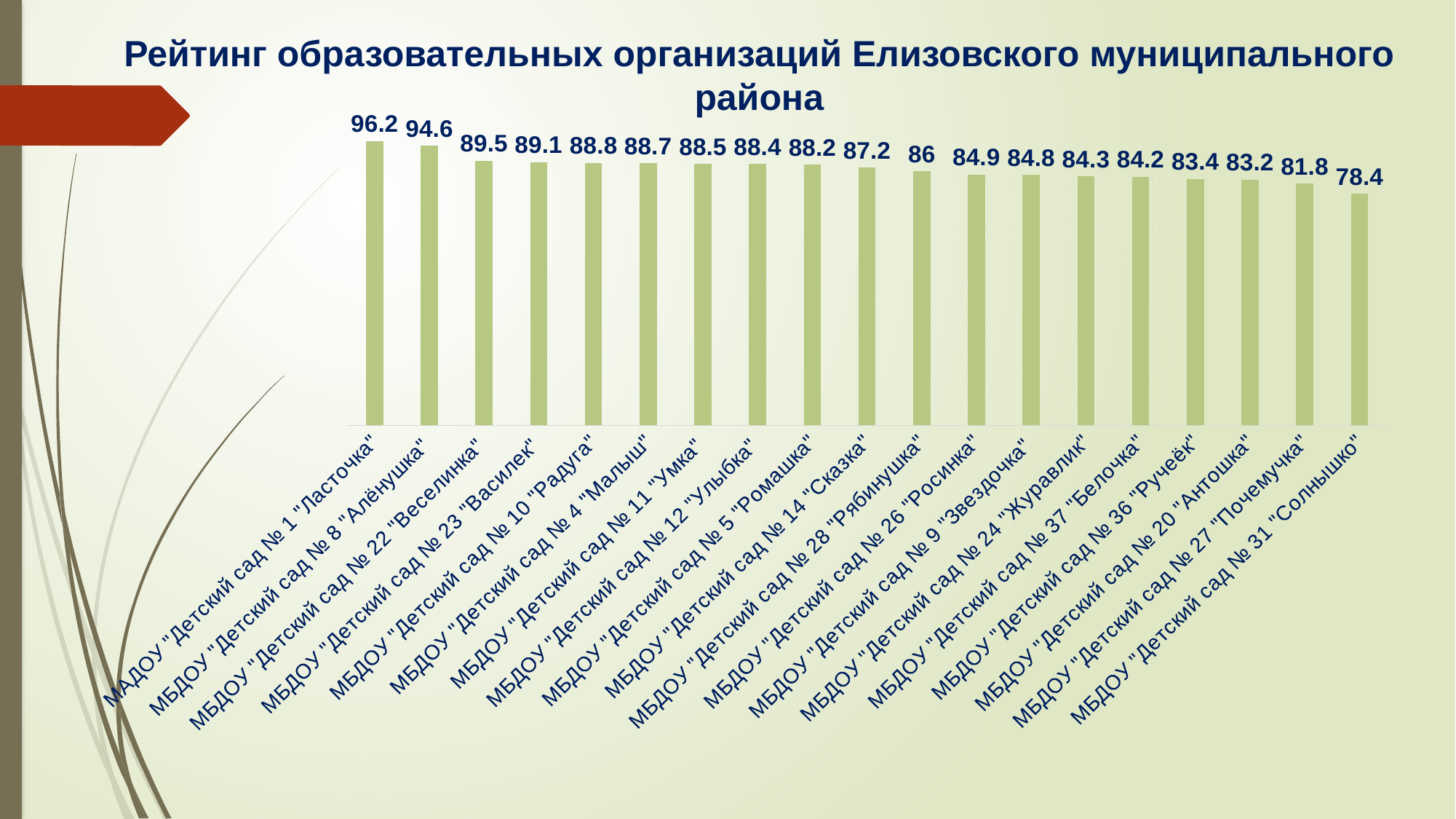
Which organisation has the lowest value? МБДОУ "Детский сад № 31 "Солнышко"" What is the value for МБДОУ "Детский сад № 28 "Рябинушка""? 86 What is the value for МБДОУ "Детский сад № 14 "Сказка""? 87.2 Do the values rise or fall from left to right along the x axis? Fall What is the difference between the values for МАДОУ "Детский сад № 1 "Ласточка"" and МБДОУ "Детский сад № 31 "Солнышко""? 17.8 Which has a larger value: МБДОУ "Детский сад № 36 "Ручеёк"" or МБДОУ "Детский сад № 26 "Росинка""? МБДОУ "Детский сад № 26 "Росинка"" How many organisations are shown in the chart? 19 What is the value for МБДОУ "Детский сад № 27 "Почемучка""? 81.8 What kind of chart is shown on the slide? Bar chart What is the difference between the values for МБДОУ "Детский сад № 8 "Алёнушка"" and МБДОУ "Детский сад № 22 "Веселинка""? 5.1 Which organisation has the highest value? МАДОУ "Детский сад № 1 "Ласточка"" What is the value for МАДОУ "Детский сад № 1 "Ласточка""? 96.2